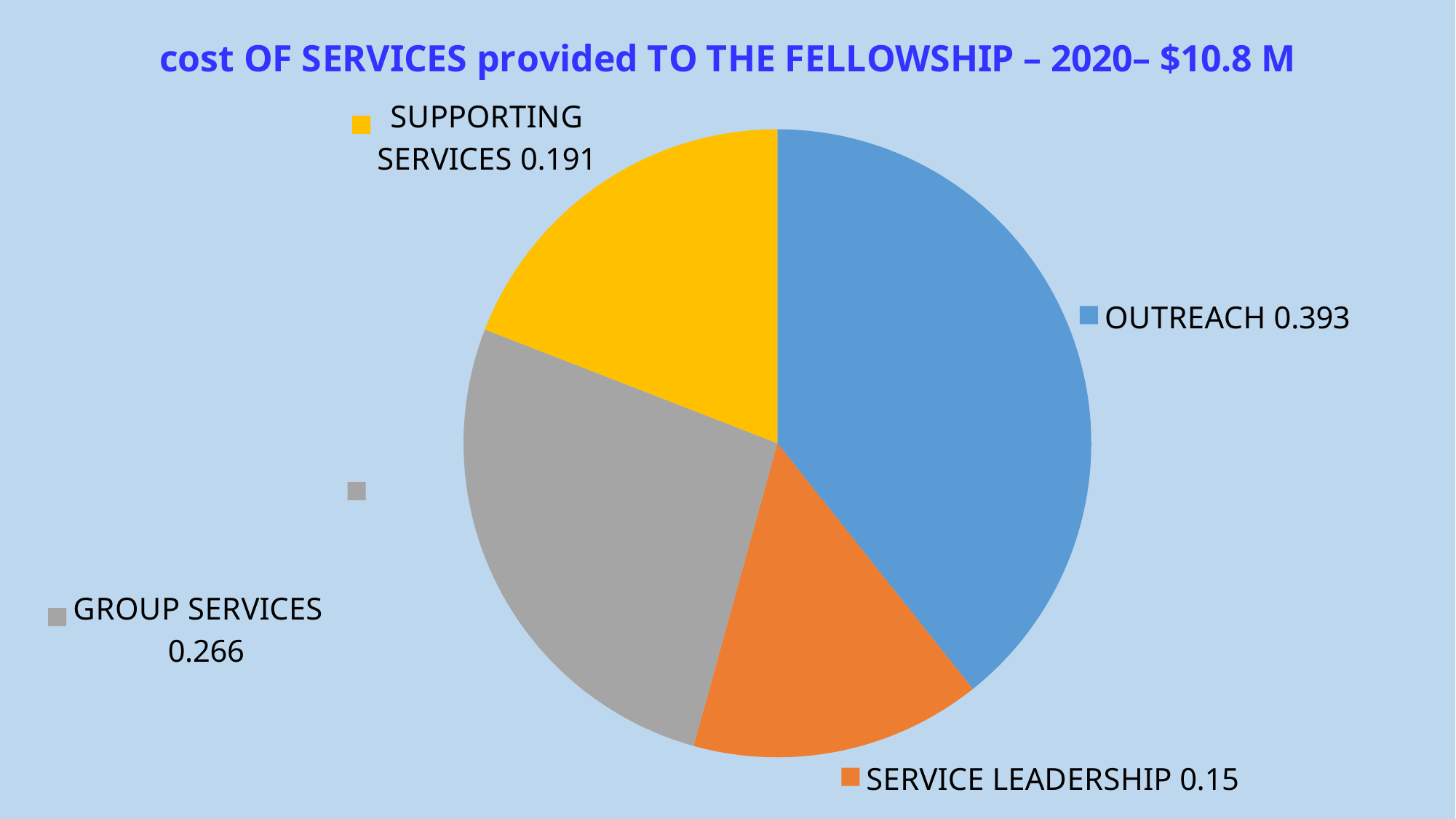
Which category has the smallest slice of the pie? SERVICE LEADERSHIP What is the value shown for GROUP SERVICES? 0.266 What kind of chart is shown on the slide? pie chart What is the value shown for SUPPORTING SERVICES? 0.191 How many categories are shown in the pie chart? 4 What is the title of the chart? cost OF SERVICES provided TO THE FELLOWSHIP – 2020– $10.8 M Which is larger, the value for GROUP SERVICES or the value for SUPPORTING SERVICES? GROUP SERVICES What is the difference between the values for OUTREACH and GROUP SERVICES? 0.127 What is the value shown for SERVICE LEADERSHIP? 0.15 Which category has the largest slice of the pie? OUTREACH What is the value shown for OUTREACH? 0.393 What is the difference between the values for SUPPORTING SERVICES and SERVICE LEADERSHIP? 0.041